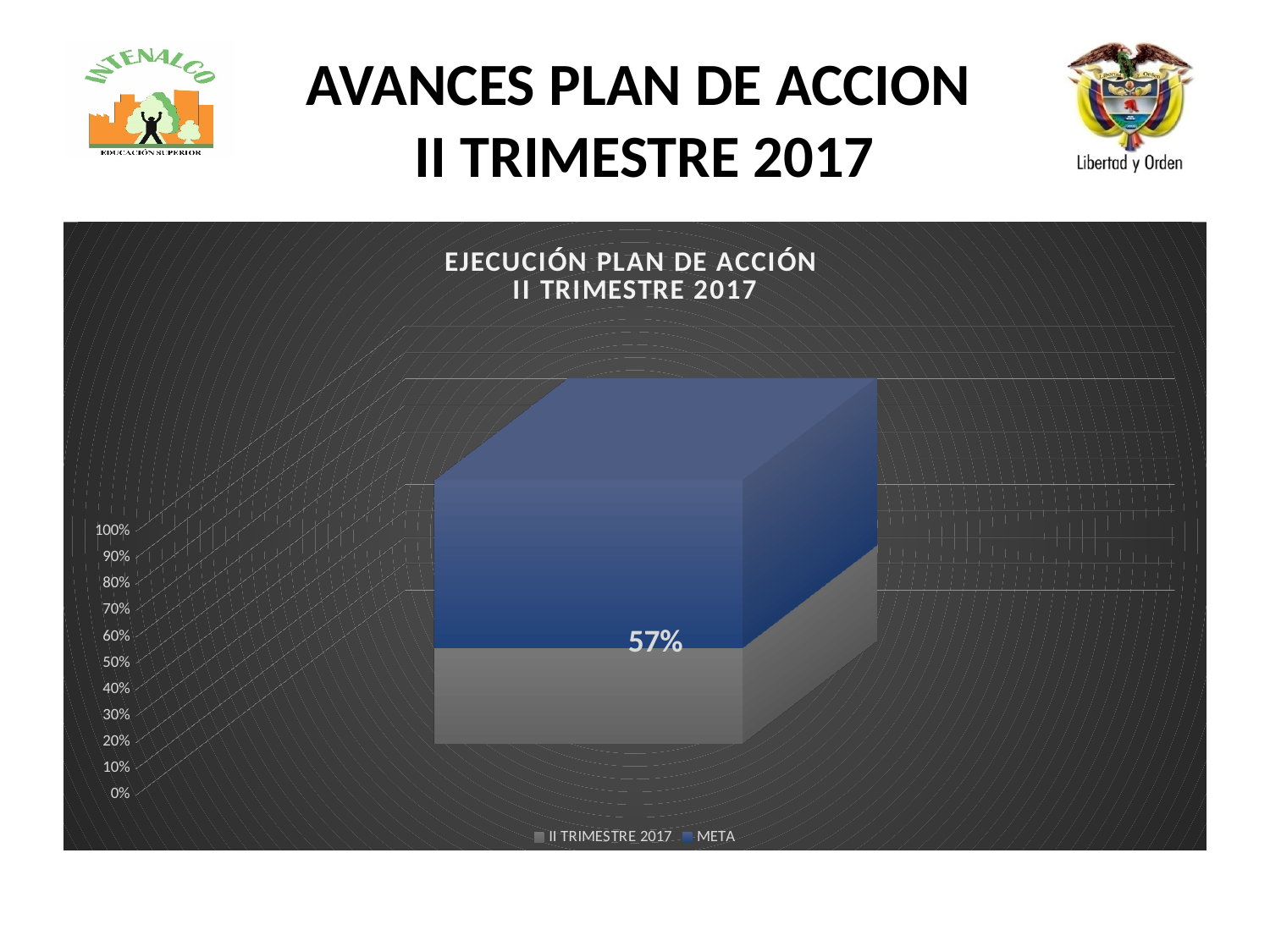
What is the highest value shown on the chart's vertical axis? 100% Is the value for II TRIMESTRE 2017 greater or less than 50%? greater What value is shown for II TRIMESTRE 2017 in the chart? 57% What kind of chart is shown on the slide? bar chart Which series is shown in blue in the chart? META What is the title of the chart? EJECUCIÓN PLAN DE ACCIÓN II TRIMESTRE 2017 How many bars are plotted in the chart? 1 How many series does the chart legend list? 2